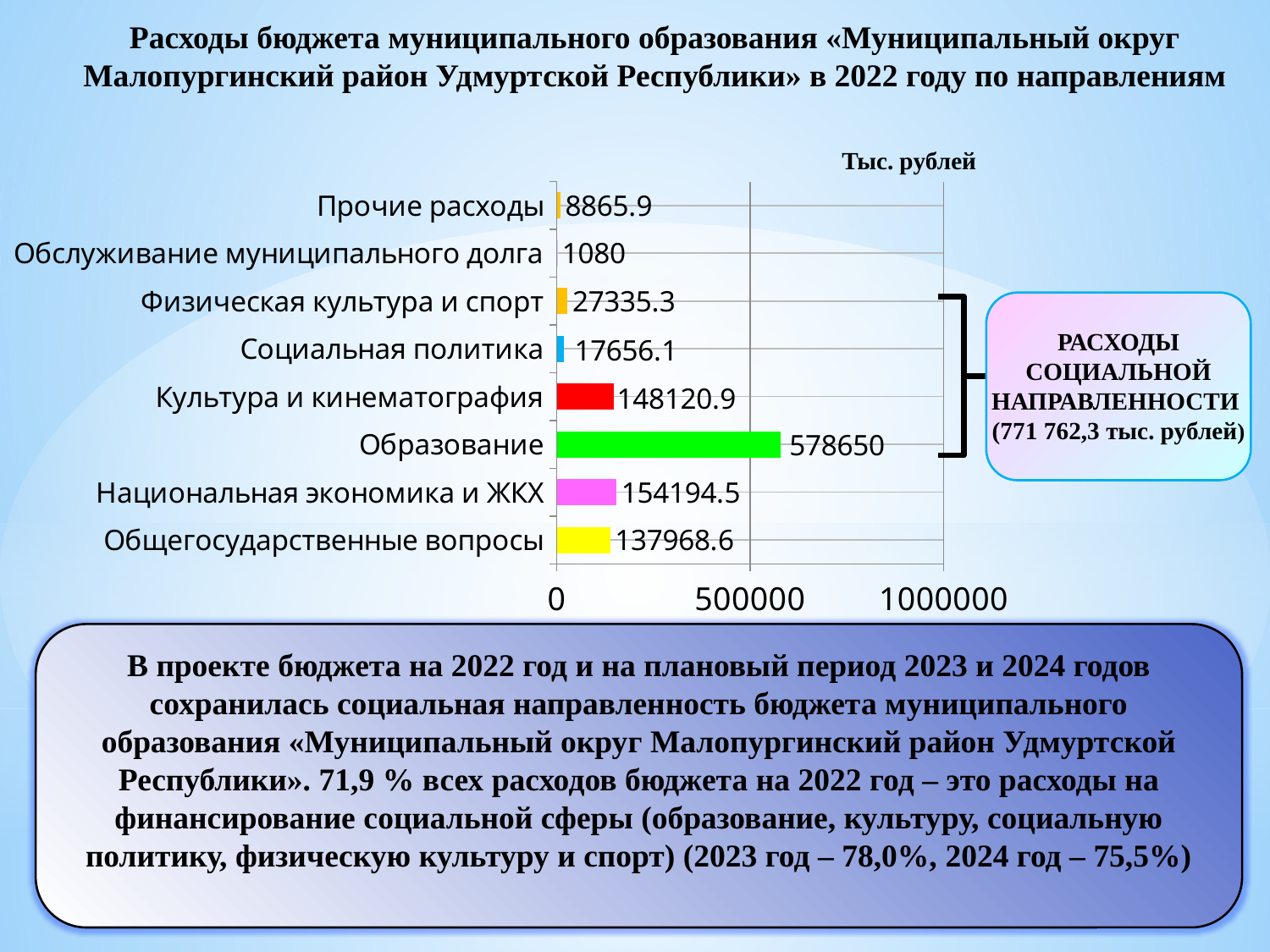
Which is larger, Общегосударственные вопросы or Национальная экономика и ЖКХ? Национальная экономика и ЖКХ What is the value for Образование? 578650 What is the difference between Физическая культура и спорт and Социальная политика? 9679.2 What is the value for Культура и кинематография? 148120.9 What is the difference between Национальная экономика и ЖКХ and Культура и кинематография? 6073.6 What is the value for Социальная политика? 17656.1 Which category has the lowest value? Обслуживание муниципального долга What kind of chart is shown on the slide? bar chart Which category has the highest value? Образование Is the value for Образование greater or less than 500000? greater What is the value for Обслуживание муниципального долга? 1080 How many categories are shown in the chart? 8